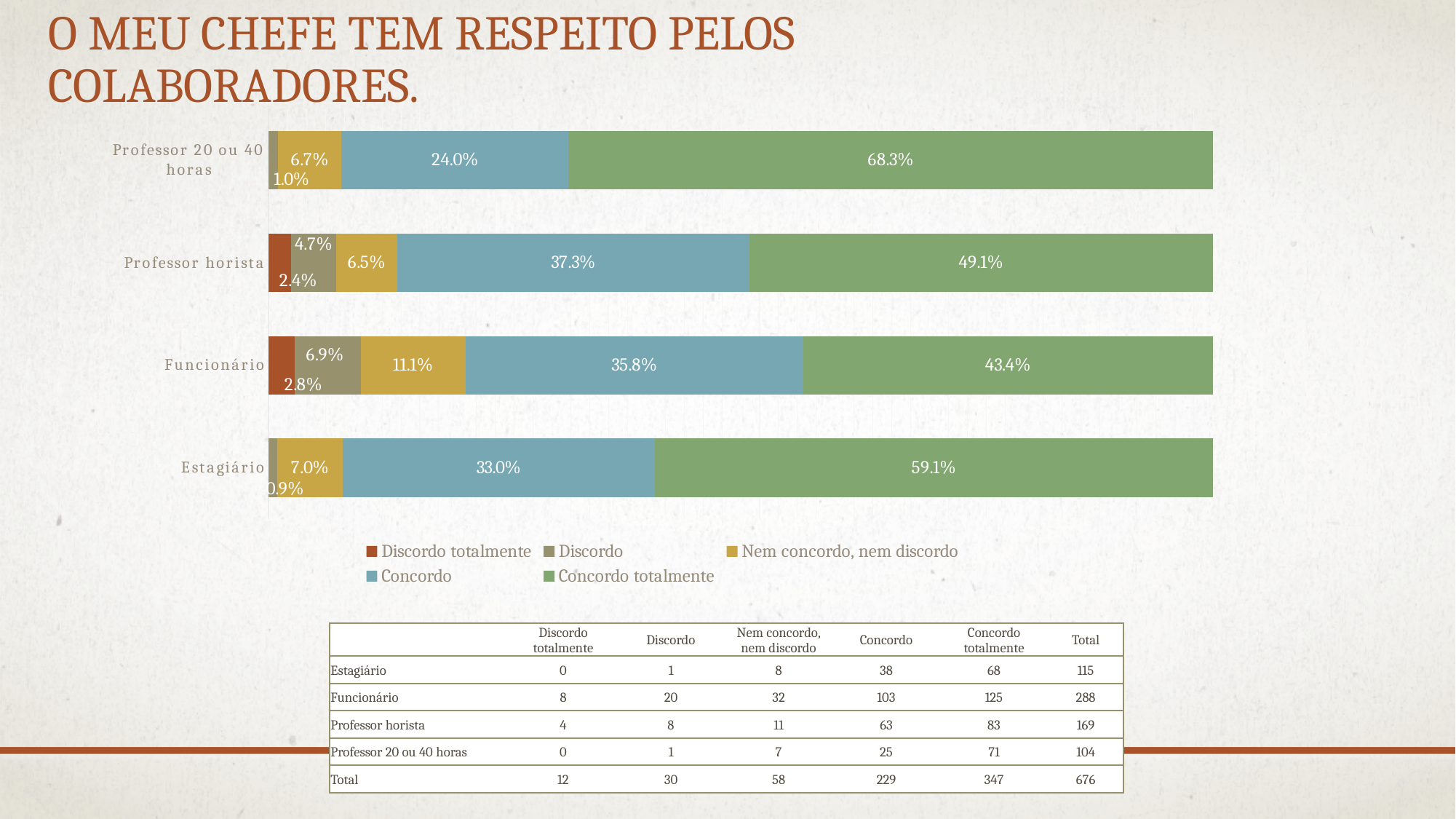
What is the 'Concordo totalmente' value for Professor 20 ou 40 horas? 68.3% What is the title of the slide above the chart? O MEU CHEFE TEM RESPEITO PELOS COLABORADORES. What is the difference between the 'Concordo totalmente' values for Estagiário and Professor horista? 10.0% Which category has the lowest 'Concordo totalmente' value? Funcionário How many categories (groups) are plotted in the chart? 4 What is the 'Nem concordo, nem discordo' value for Funcionário? 11.1% What is the 'Discordo' value for Estagiário? 0.9% What type of chart is shown on the slide? Stacked bar chart Which category has the highest 'Concordo totalmente' value? Professor 20 ou 40 horas How many series does the chart legend list? 5 Which is larger: the 'Concordo' value for Funcionário or for Estagiário? Funcionário What is the 'Concordo' value for Professor horista? 37.3%